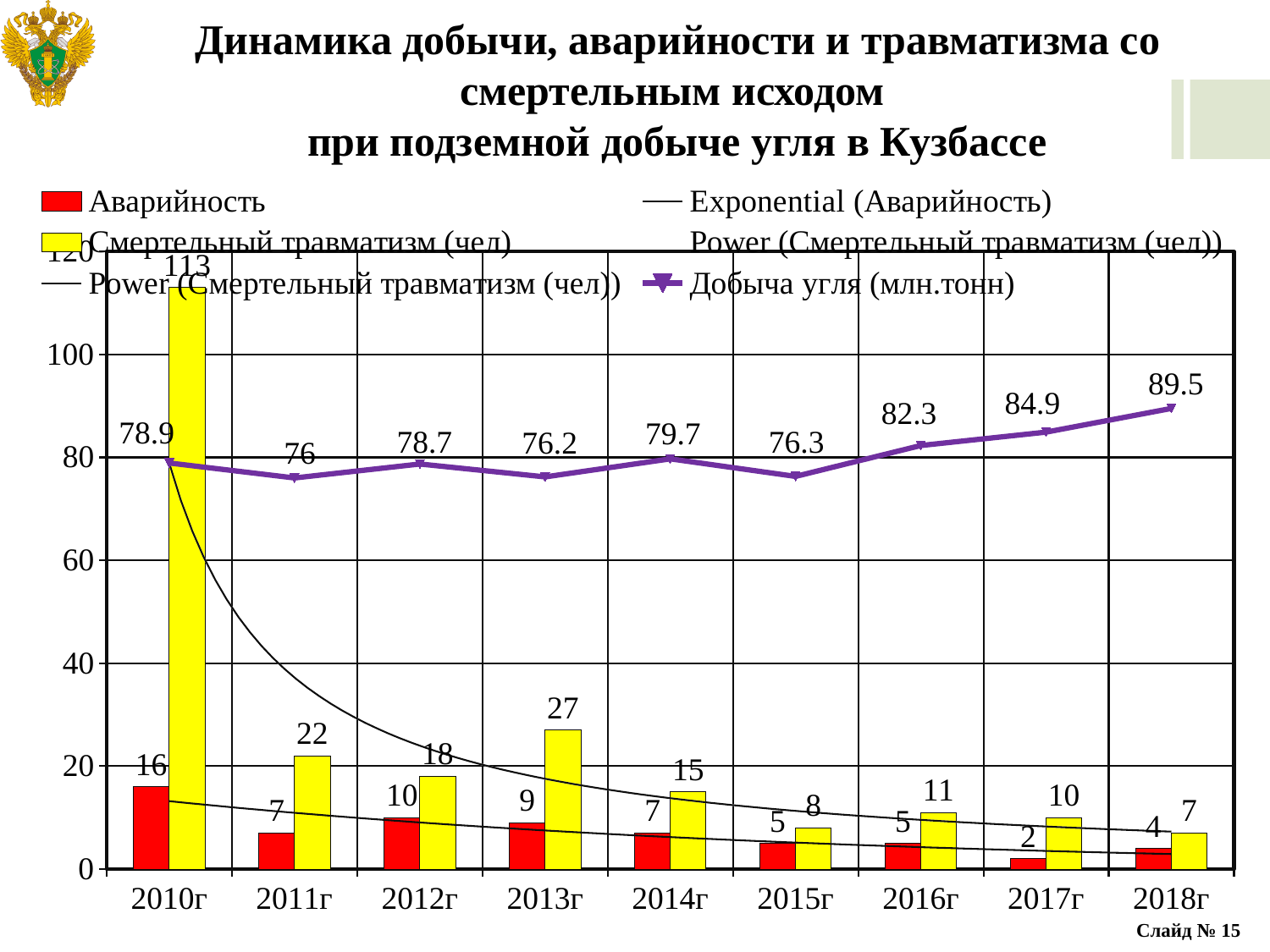
Is the value of Добыча угля (млн.тонн) for 2017г greater or less than 80? greater What is the difference between Смертельный травматизм (чел) in 2011г and in 2012г? 4 In which year is Аварийность lowest? 2017г What is the value of Смертельный травматизм (чел) for 2013г? 27 What is the value of Добыча угля (млн.тонн) for 2018г? 89.5 In which year is Добыча угля (млн.тонн) lowest? 2011г What is the value of Аварийность for 2010г? 16 In which year is Смертельный травматизм (чел) highest? 2010г What colour are the bars for Смертельный травматизм (чел)? Yellow How many years are shown on the x axis? 9 Which is larger: Добыча угля (млн.тонн) in 2014г or in 2015г? 2014г How many entries does the legend list? 6